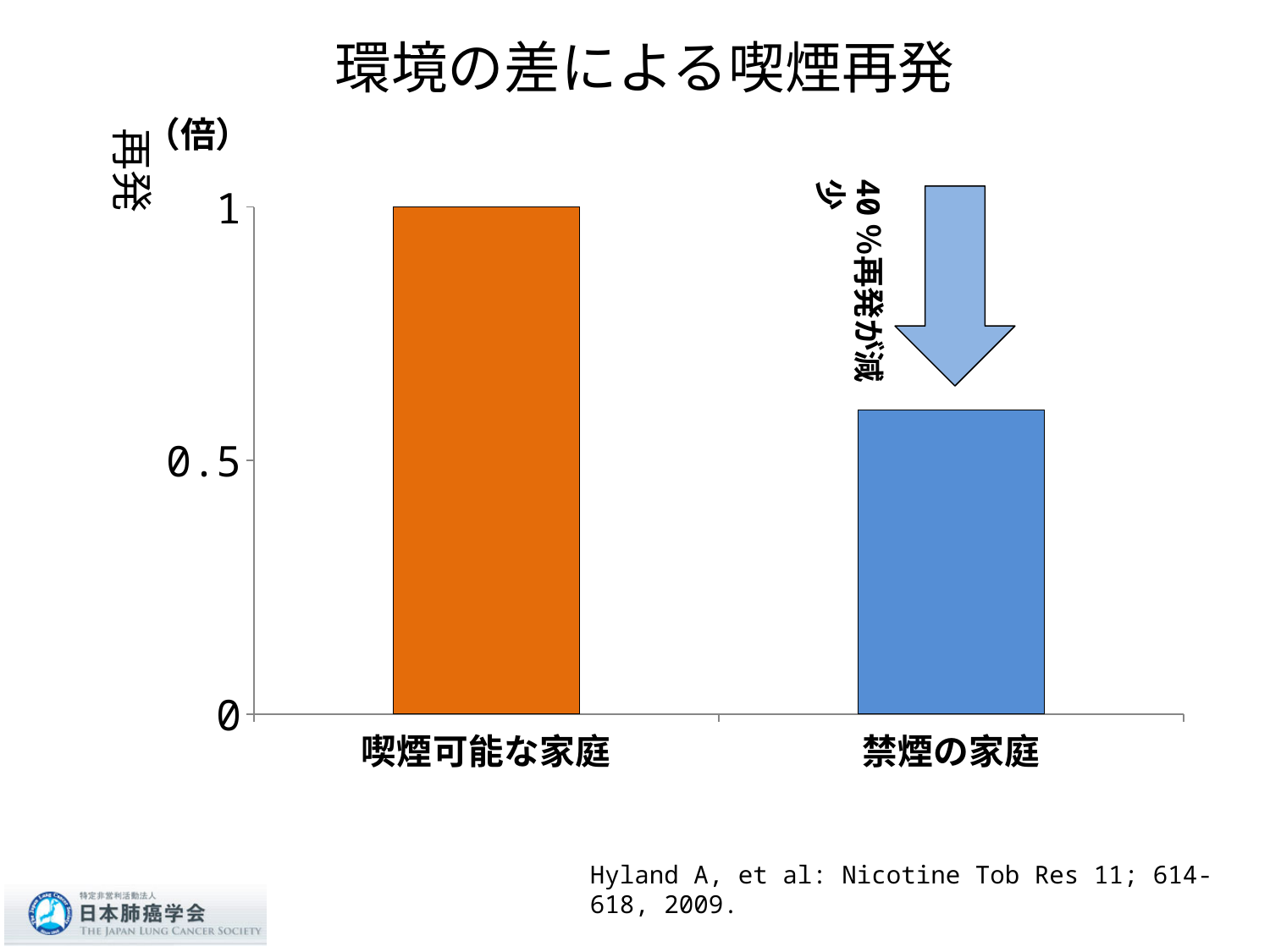
Which category has the lowest value? 禁煙の家庭 What unit is shown at the top of the y axis? (倍) Which category has the highest value? 喫煙可能な家庭 What is the title of the chart? 環境の差による喫煙再発 Do the values rise or fall from left to right along the x axis? fall Is the value for 禁煙の家庭 greater or less than 0.5? greater What is the value for 喫煙可能な家庭? 1 Is the value for 禁煙の家庭 greater or less than 1? less What kind of chart is shown on the slide? bar chart How many categories are plotted on the x axis? 2 Which is larger, the value for 喫煙可能な家庭 or the value for 禁煙の家庭? 喫煙可能な家庭